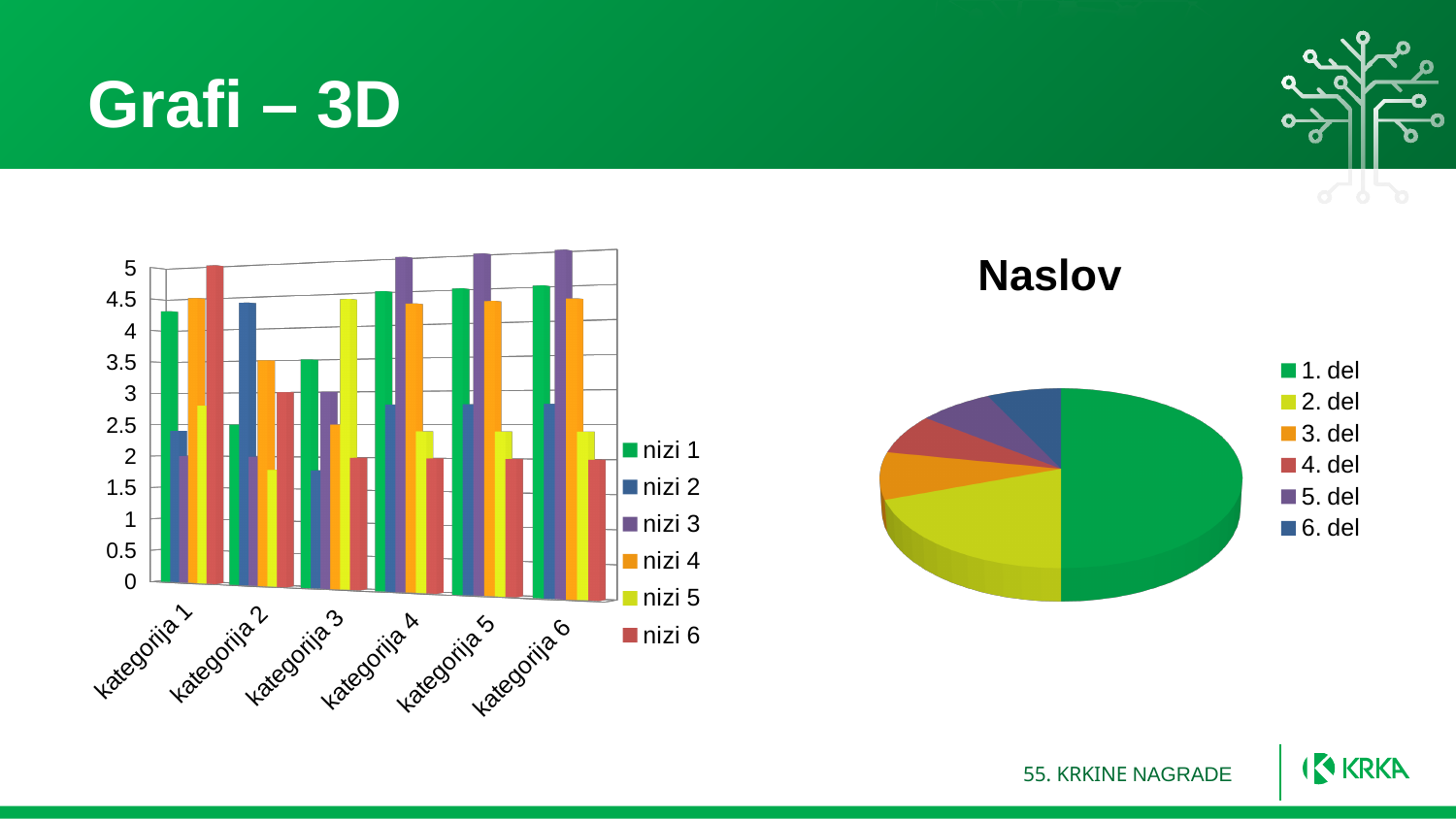
In the bar chart on the left, how many series does the legend list? 6 In the bar chart on the left, which is larger in kategorija 1, nizi 6 or nizi 2? nizi 6 In the bar chart on the left, is the value for nizi 1 in kategorija 1 greater or less than 3? greater In the bar chart on the left, how many categories are shown on the x axis? 6 What is the title of the pie chart on the right of the slide? Naslov In the pie chart titled "Naslov", how many entries does the legend list? 6 In the pie chart titled "Naslov", which slice is larger, 1. del or 2. del? 1. del In the pie chart titled "Naslov", which slice is the largest? 1. del What kind of chart is the chart titled "Naslov"? pie chart What kind of chart is the chart on the left of the slide? bar chart In the bar chart on the left, is the value for nizi 6 in kategorija 1 greater or less than 4? greater In the bar chart on the left, is the value for nizi 5 in kategorija 2 greater or less than 3? less